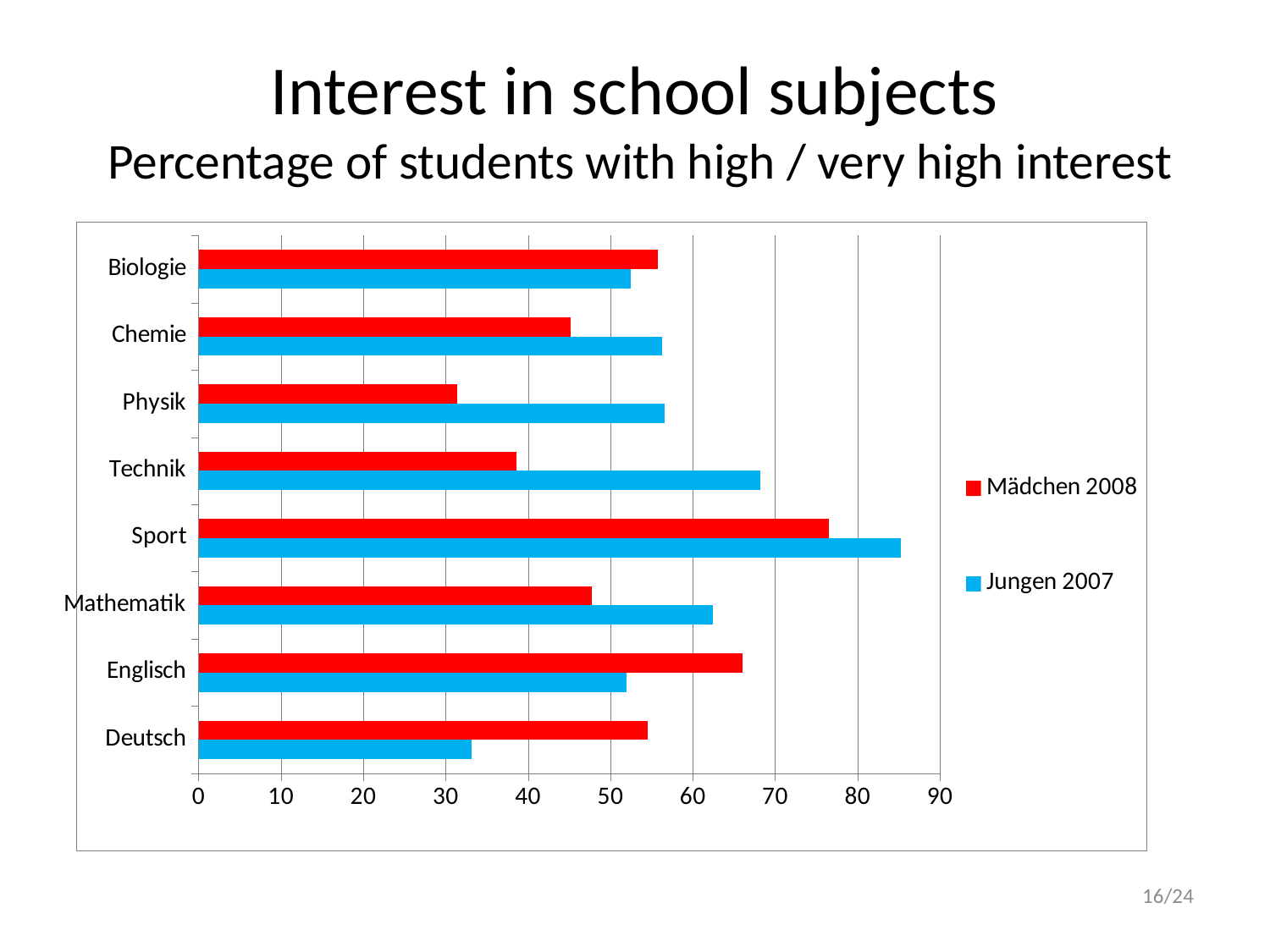
Which subject has the highest value for Jungen 2007? Sport How many series does the legend list? 2 Which subject has the lowest value for Jungen 2007? Deutsch Is the value for Technik in the Jungen 2007 series greater or less than 60? greater Which subject has the lowest value for Mädchen 2008? Physik Is the value for Sport in the Jungen 2007 series greater or less than 80? greater Is the value for Physik in the Mädchen 2008 series greater or less than 40? less For Technik, which series has the larger value, Mädchen 2008 or Jungen 2007? Jungen 2007 What kind of chart is shown on the slide? bar chart Which subject has the highest value for Mädchen 2008? Sport How many school subjects are listed on the chart? 8 For Deutsch, which series has the larger value, Mädchen 2008 or Jungen 2007? Mädchen 2008